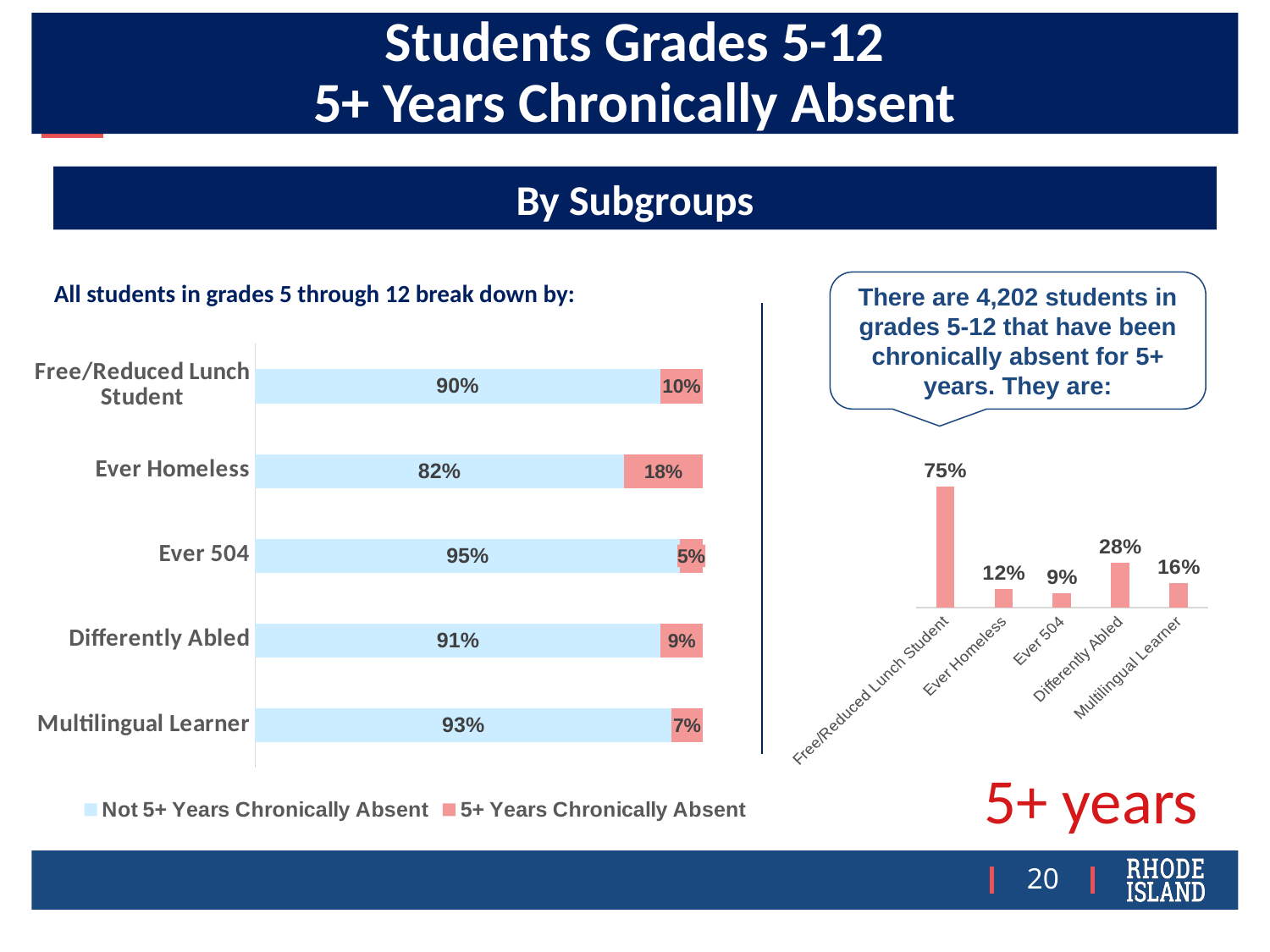
How many subgroups are shown in the left-hand stacked bar chart? 5 In the left-hand stacked bar chart, which subgroup has the lowest share of 5+ Years Chronically Absent students? Ever 504 In the left-hand stacked bar chart, what is the difference between the 5+ Years Chronically Absent share for Free/Reduced Lunch Student and Multilingual Learner? 3% How many series does the legend of the left-hand stacked bar chart list? 2 In the right-hand bar chart, what percentage is shown for Differently Abled? 28% What type of chart is the right-hand chart on the slide? bar chart In the left-hand stacked bar chart, what percentage of Ever Homeless students are 5+ Years Chronically Absent? 18% In the right-hand bar chart, is the value for Multilingual Learner larger or smaller than the value for Ever Homeless? larger In the left-hand stacked bar chart, which subgroup has the highest share of 5+ Years Chronically Absent students? Ever Homeless In the right-hand bar chart, what percentage is shown for Free/Reduced Lunch Student? 75% In the left-hand stacked bar chart, what percentage of Ever 504 students are Not 5+ Years Chronically Absent? 95% In the right-hand bar chart, which category has the lowest value? Ever 504